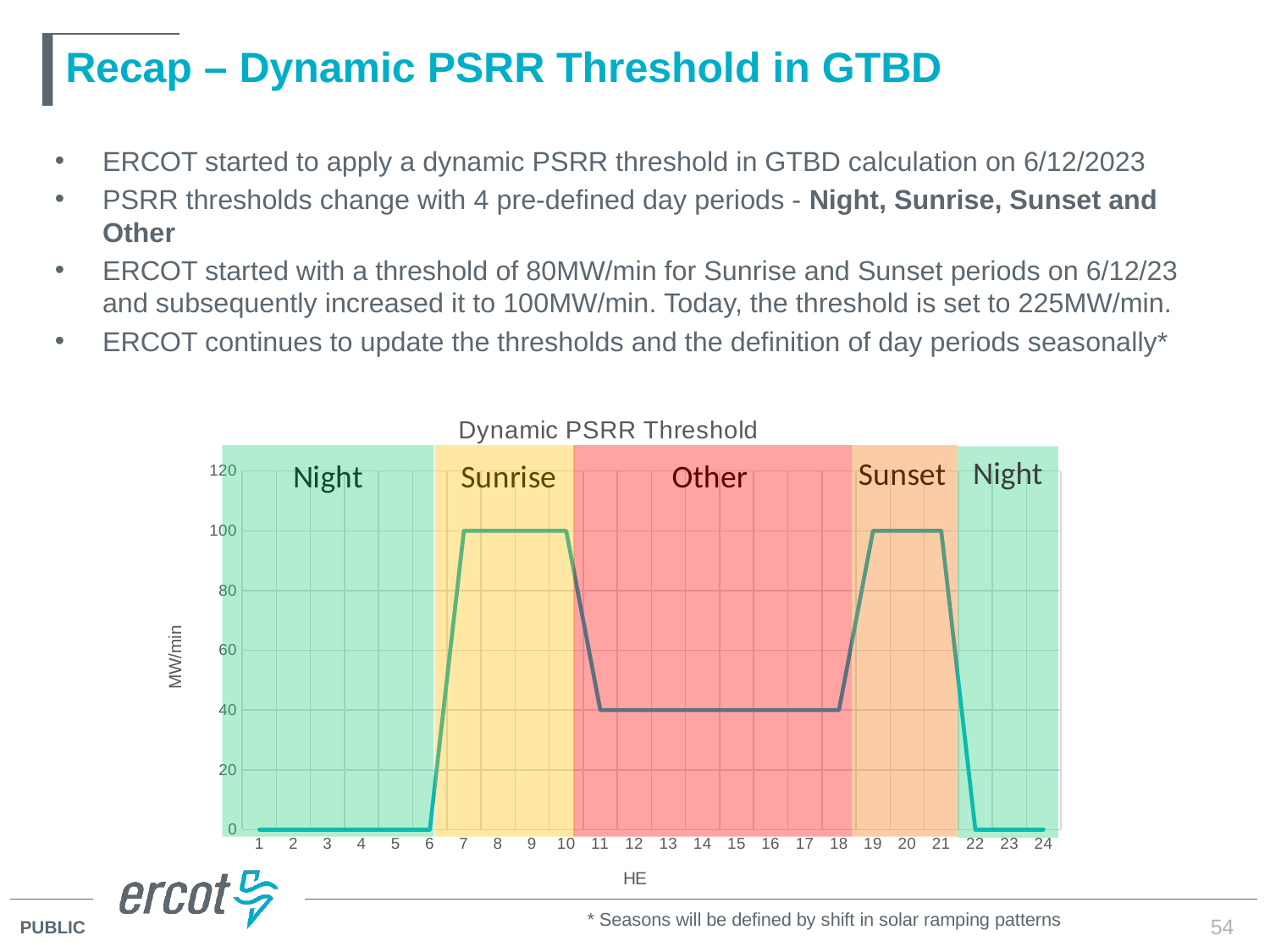
What is the title of the chart? Dynamic PSRR Threshold What is the value of the threshold at HE 20? 100 What is the value of the threshold at HE 8? 100 What is the y-axis label of the chart? MW/min What is the value of the threshold at HE 3? 0 What is the value of the threshold at HE 14? 40 Which of HE 9 or HE 15 has the higher threshold value? HE 9 How many hour-ending points are shown on the x axis? 24 Is the threshold value at HE 12 greater or less than 60? less What is the difference between the threshold at HE 8 and the threshold at HE 14? 60 What kind of chart is shown on the slide? line chart Does the threshold rise or fall between HE 10 and HE 11? fall